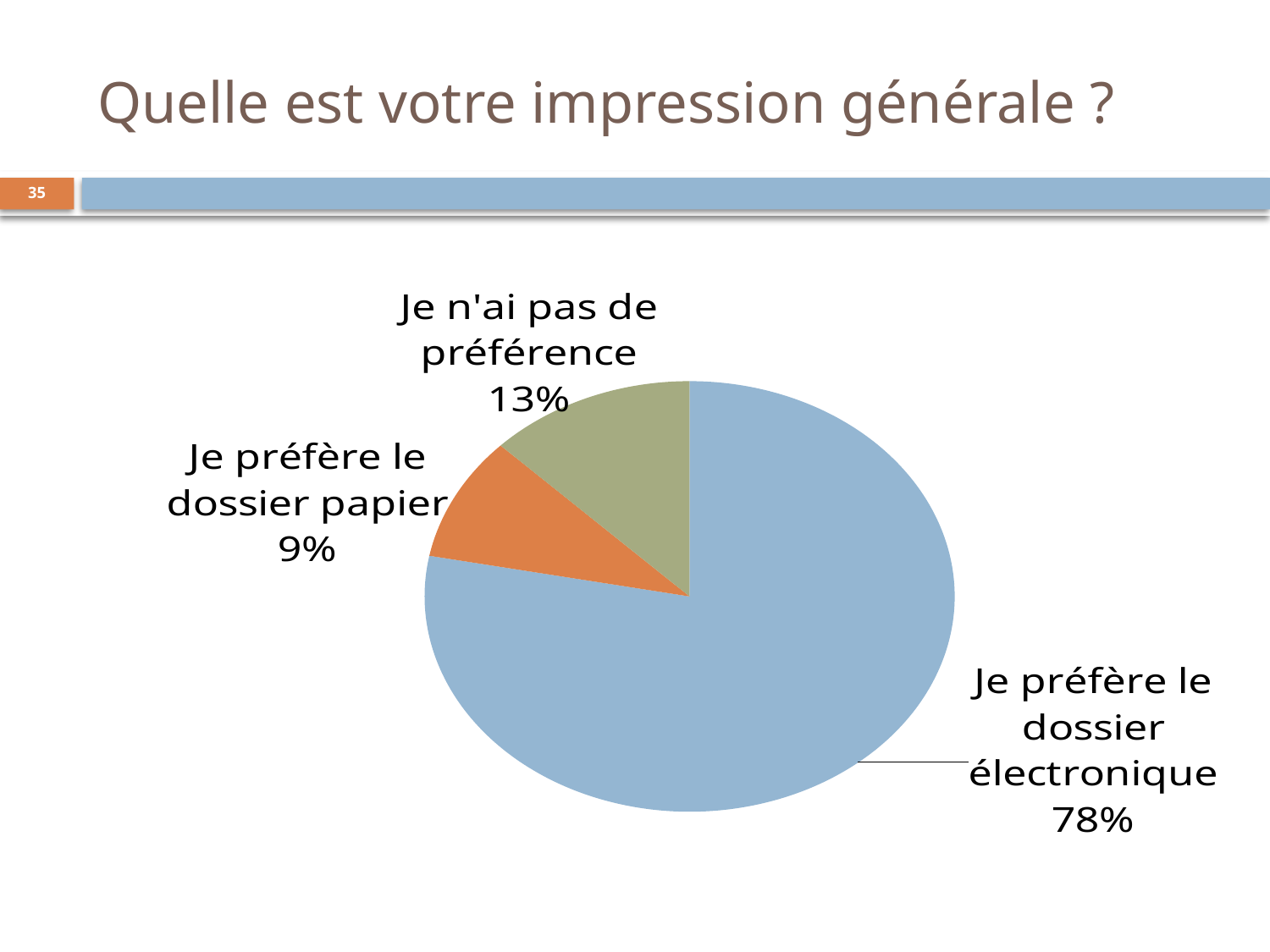
What kind of chart is shown on the slide? Pie chart What share of the pie is labelled "Je préfère le dossier papier"? 9% What share of the pie is labelled "Je n'ai pas de préférence"? 13% What share of the pie is labelled "Je préfère le dossier électronique"? 78% What colour is the slice for "Je préfère le dossier papier"? Orange What is the difference in percentage points between "Je préfère le dossier électronique" and "Je n'ai pas de préférence"? 65 Which slice of the pie is the largest? Je préfère le dossier électronique How many slices does the pie chart have? 3 What is the difference in percentage points between "Je n'ai pas de préférence" and "Je préfère le dossier papier"? 4 What is the title of the slide containing the pie chart? Quelle est votre impression générale ? Which slice of the pie is the smallest? Je préfère le dossier papier Which is larger: the share for "Je n'ai pas de préférence" or the share for "Je préfère le dossier papier"? Je n'ai pas de préférence